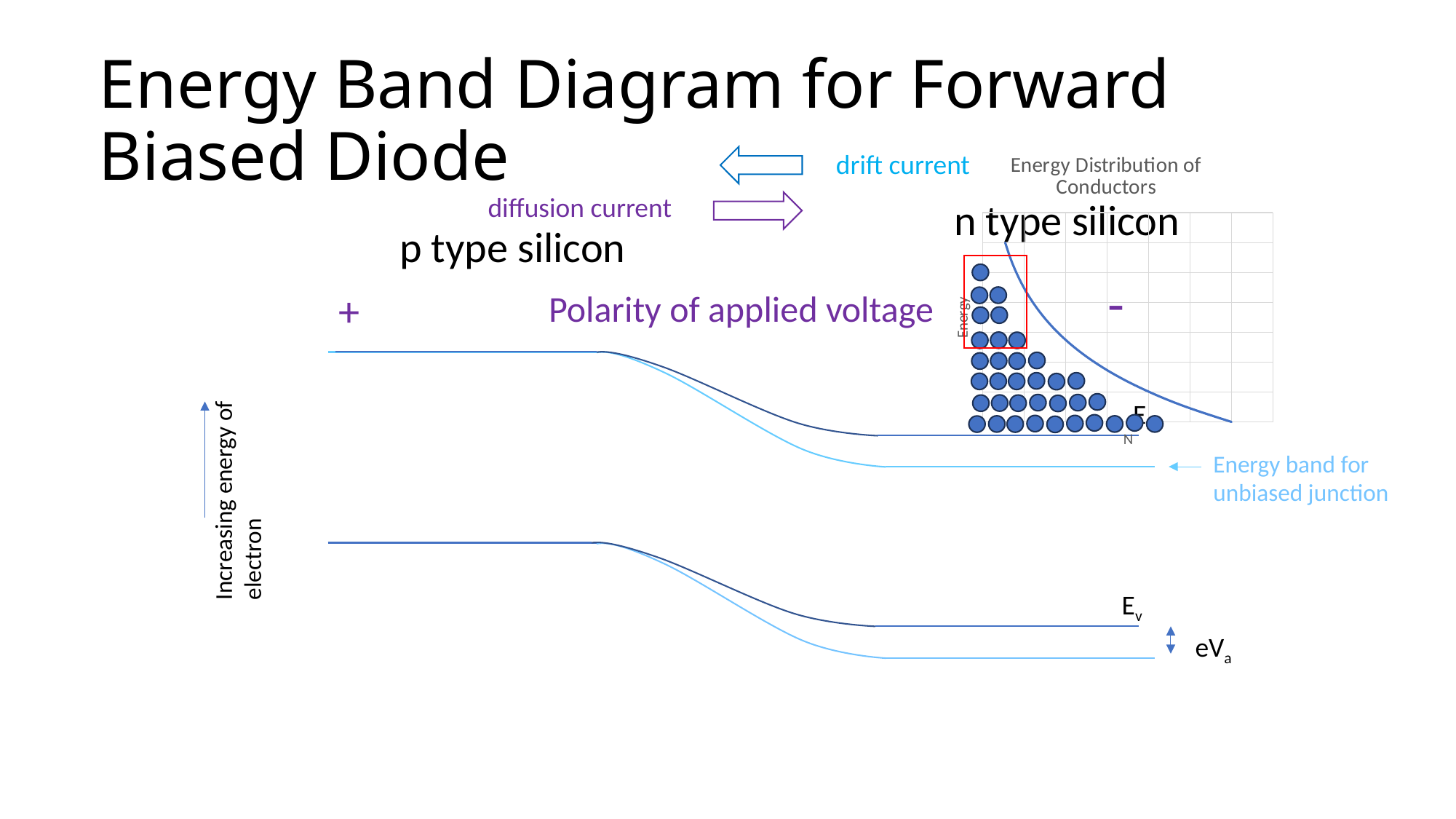
What is the title of the small chart in the upper right of the slide? Energy Distribution of Conductors In the Energy Distribution of Conductors chart, does the curve rise or fall from left to right? fall In the main energy band diagram, what does the light blue line represent according to the label on the right? Energy band for unbiased junction What kind of chart is the Energy Distribution of Conductors chart? line chart In the main energy band diagram, do the band lines rise or fall when moving from the p type silicon side to the n type silicon side? fall